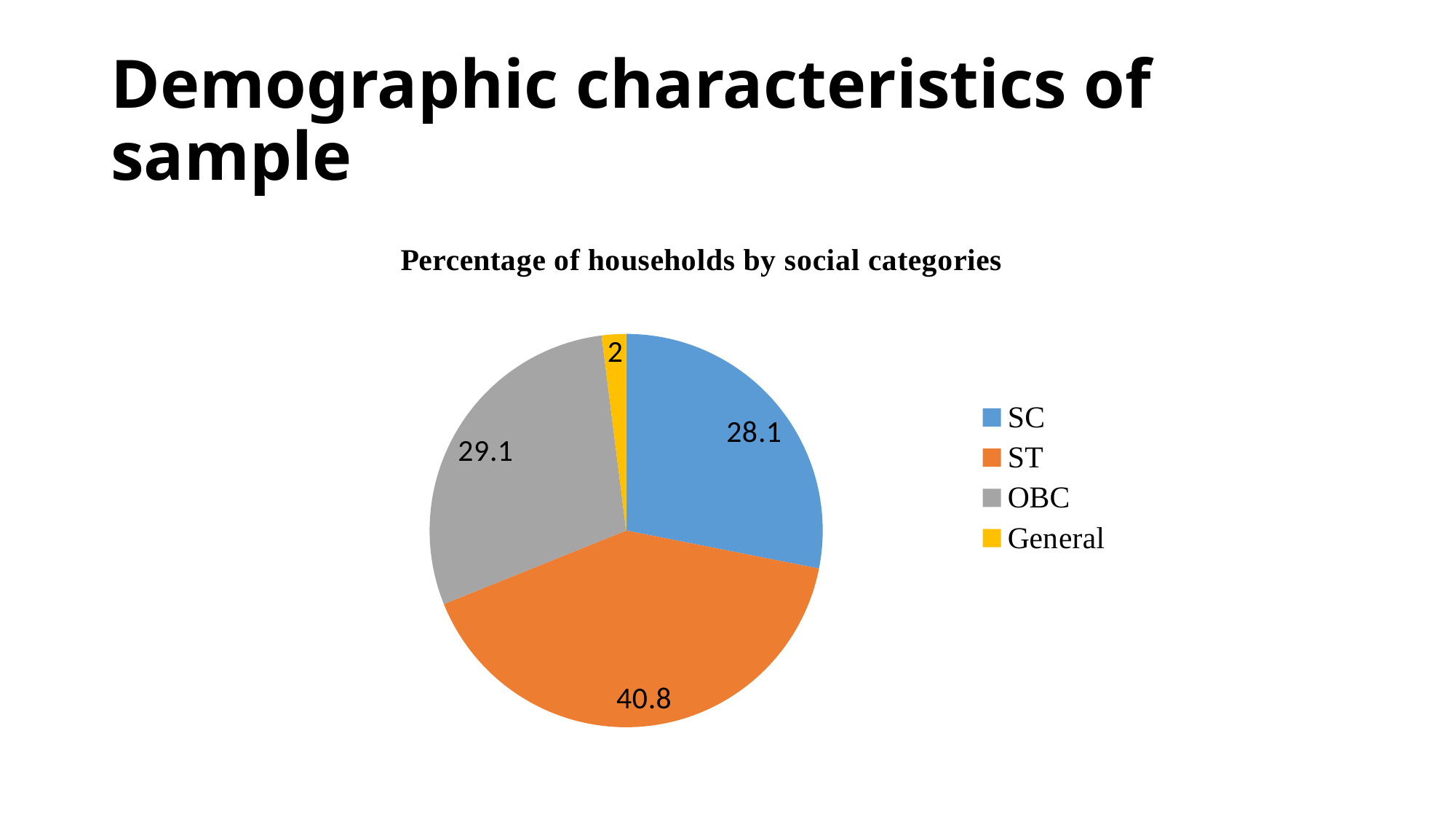
Which social category has the smallest share of households? General Which social category has the largest share of households? ST What is the value for ST? 40.8 Which is larger, the value for OBC or the value for SC? OBC What is the value for SC? 28.1 What is the value for General? 2 Which colour represents OBC in the chart? grey How many categories does the pie chart show? 4 What is the value for OBC? 29.1 What kind of chart is shown on the slide? pie chart What is the chart's title? Percentage of households by social categories What is the difference between the values for ST and SC? 12.7